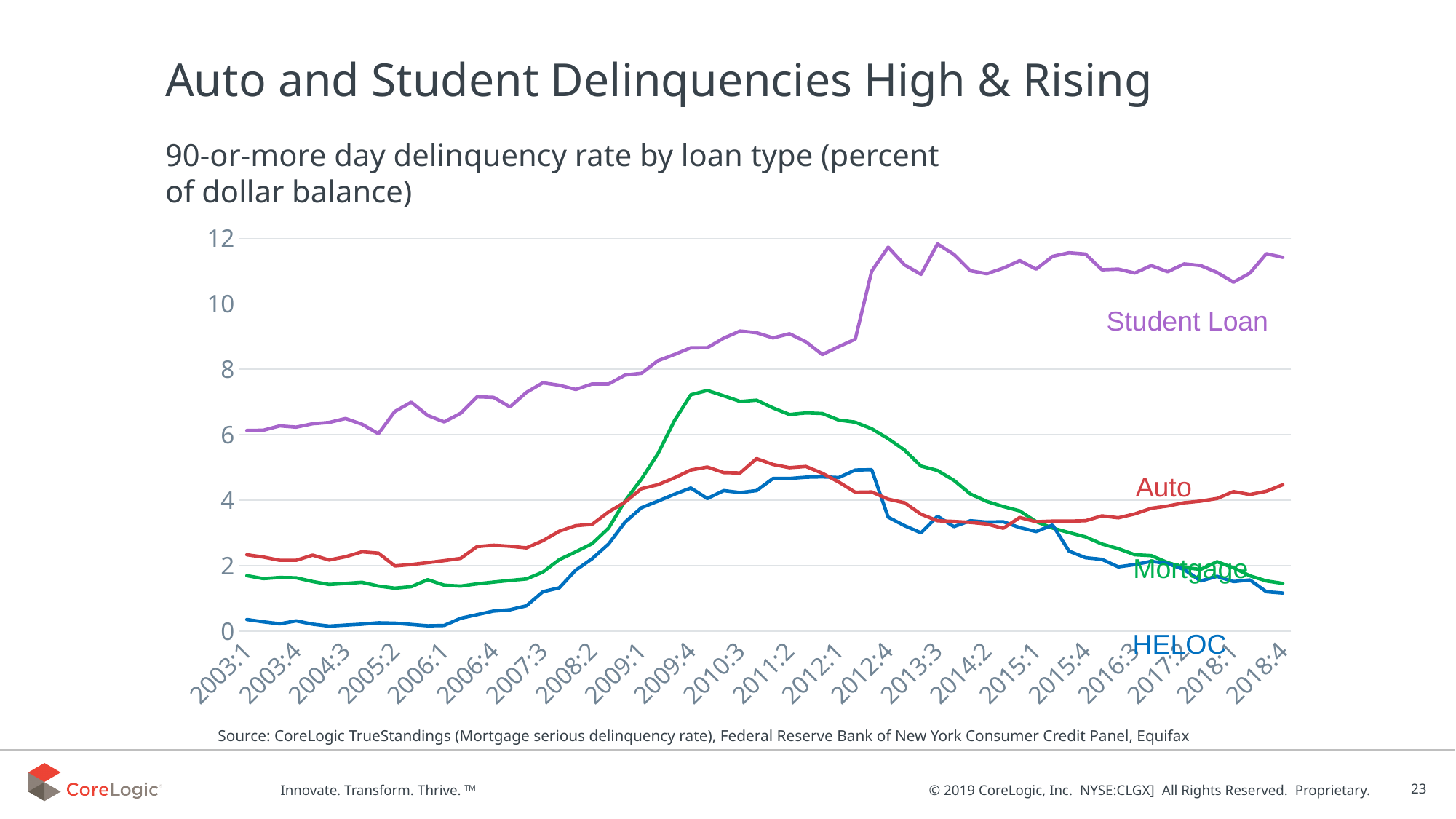
Is the HELOC delinquency rate in 2003:1 greater or less than 2? less Does the Mortgage delinquency rate rise or fall from 2010:1 to 2018:4? fall Which loan type has the lowest delinquency rate in 2003:1? HELOC What kind of chart is shown on the slide? line chart Does the Student Loan delinquency rate rise or fall from 2003:1 to 2012:4? rise What is the title of the slide? Auto and Student Delinquencies High & Rising How many loan-type series are plotted on the chart? 4 Which is larger in 2009:4, the Mortgage delinquency rate or the Auto delinquency rate? Mortgage Which loan type has the highest 90-or-more day delinquency rate in 2018:4? Student Loan Is the Auto delinquency rate in 2018:4 greater or less than 4? greater Is the Mortgage delinquency rate in 2018:4 greater or less than 2? less